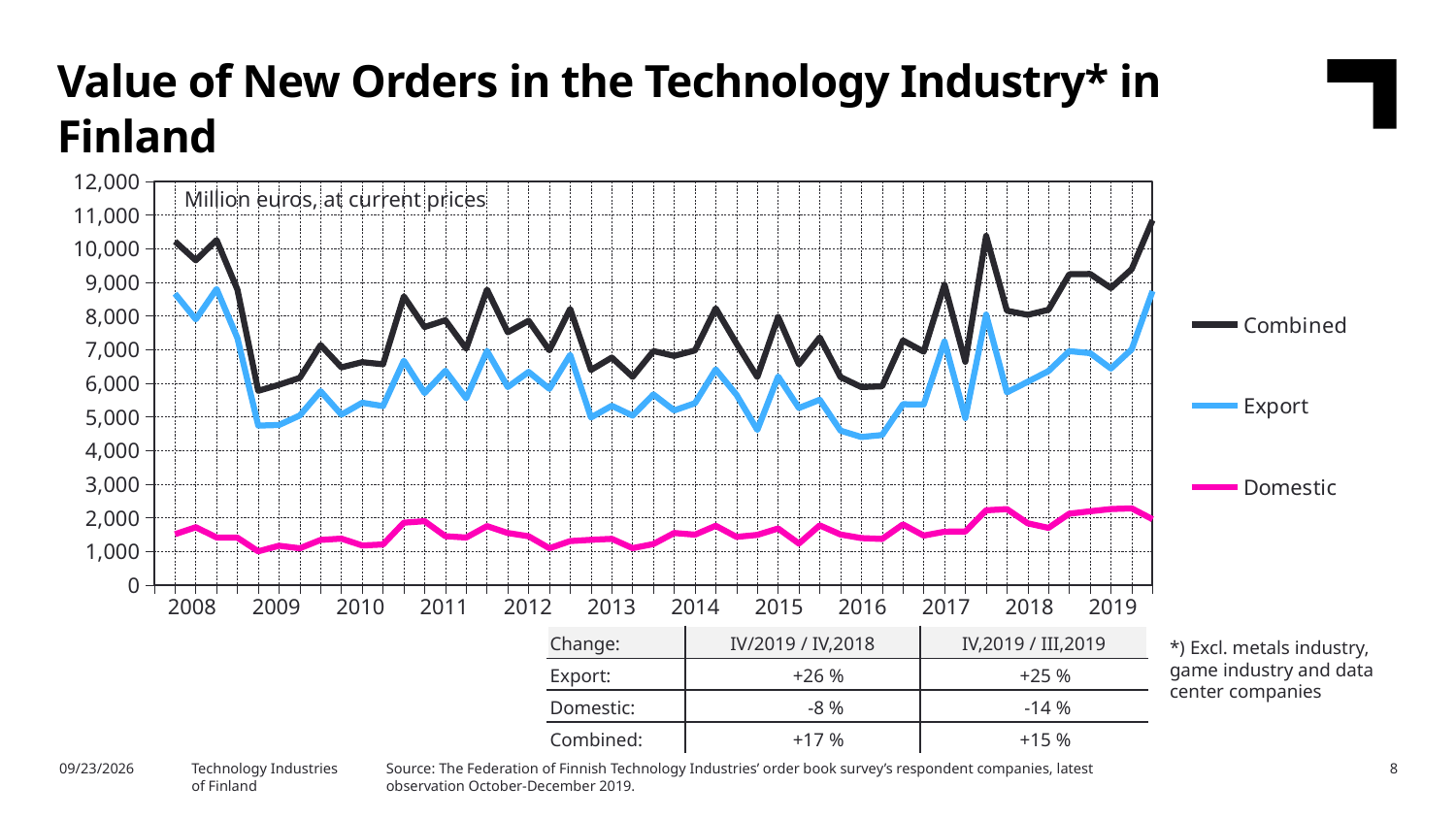
Which series has the highest values throughout the chart? Combined Does the Combined series rise or fall from the start of 2008 to the start of 2009? fall How many series does the legend list? 3 How many year labels are shown on the x axis? 12 Is the value for Combined at the end of 2019 greater or less than 10,000? greater Which series has the lowest values throughout the chart? Domestic What kind of chart is shown on the slide? line chart Is the value for Export at the end of 2019 greater or less than 8,000? greater Which is larger at the end of 2019, the Export value or the Domestic value? Export What unit is stated in the label inside the chart area? Million euros, at current prices Is the value for Domestic at the start of 2008 greater or less than 3,000? less What are the three series named in the legend? Combined, Export, Domestic